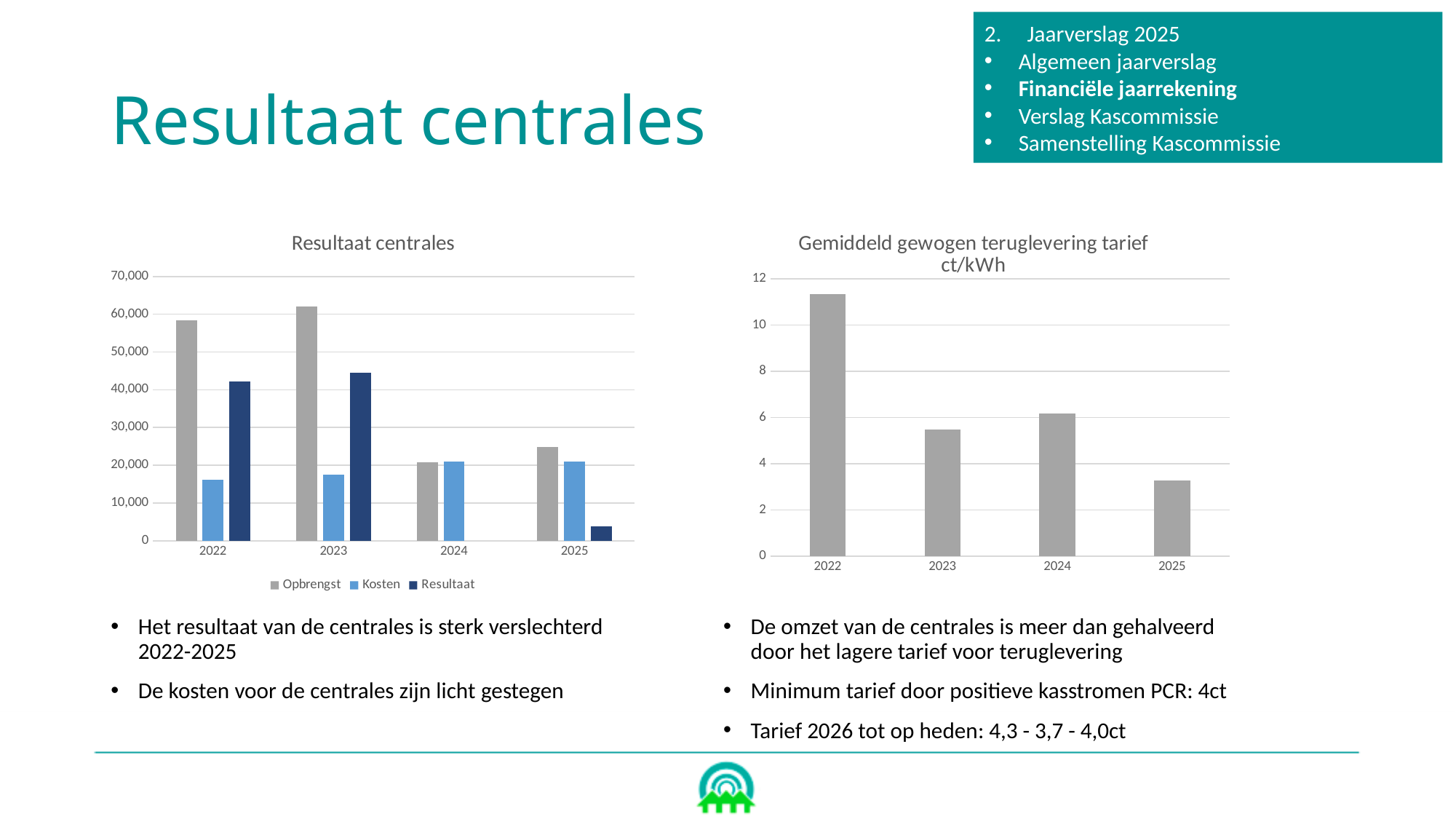
In the 'Resultaat centrales' chart, is the Kosten value for 2022 greater or less than 20,000? less In the 'Resultaat centrales' chart, is the Opbrengst for 2022 greater or less than 50,000? greater In the 'Resultaat centrales' chart, which year has the highest Opbrengst? 2023 In the 'Resultaat centrales' chart, which is larger: Opbrengst in 2022 or Opbrengst in 2025? Opbrengst in 2022 How many years are shown on the x axis of the 'Gemiddeld gewogen teruglevering tarief ct/kWh' chart? 4 In the 'Gemiddeld gewogen teruglevering tarief ct/kWh' chart, is the value for 2025 greater or less than 4? less What kind of chart is the 'Resultaat centrales' chart on the left? bar chart In the 'Gemiddeld gewogen teruglevering tarief ct/kWh' chart, which is larger: the value for 2023 or the value for 2024? 2024 How many series does the legend of the 'Resultaat centrales' chart list? 3 In the 'Gemiddeld gewogen teruglevering tarief ct/kWh' chart, which year has the highest value? 2022